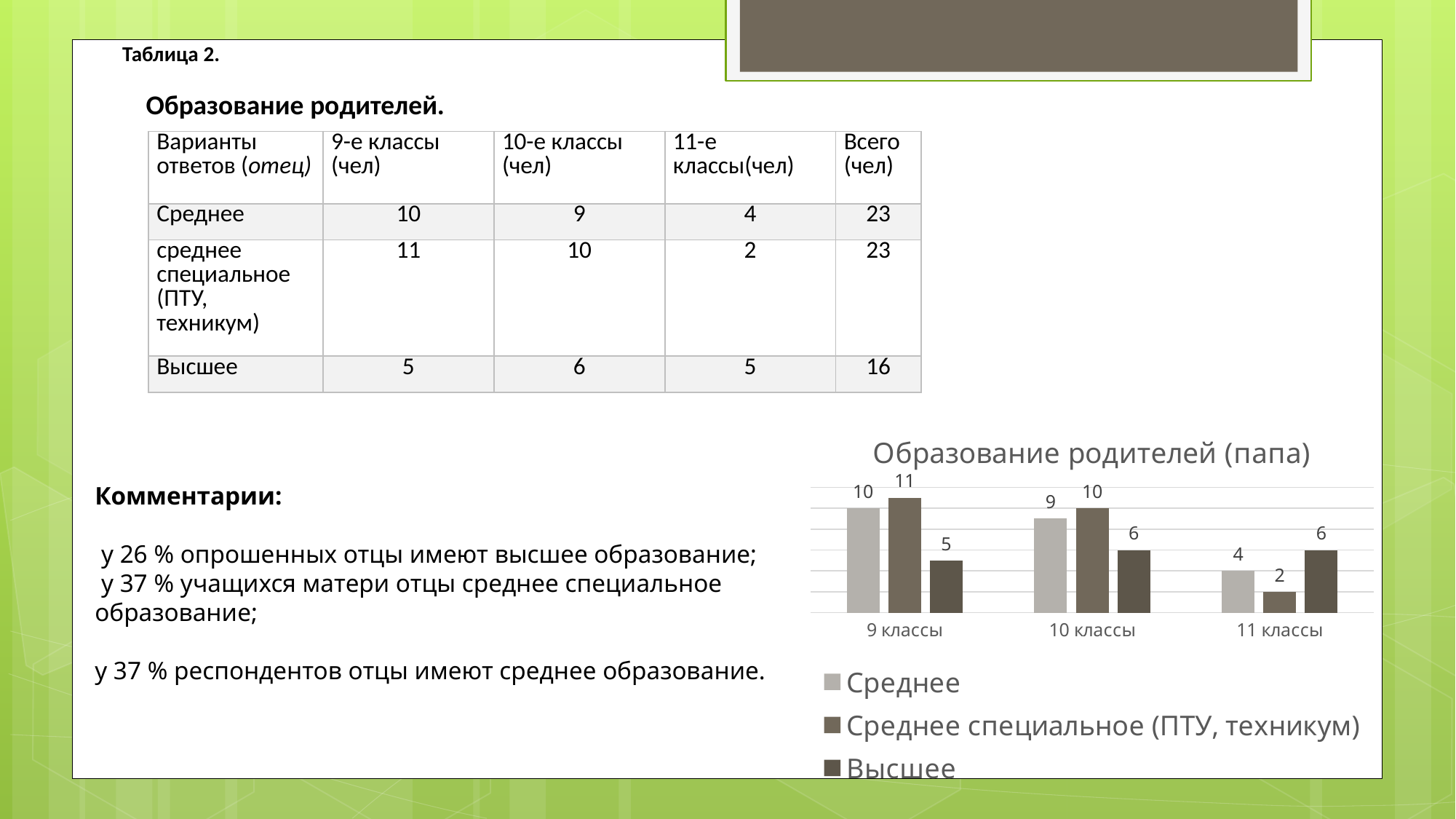
Does the Среднее специальное (ПТУ, техникум) series rise or fall from 9 классы to 11 классы? fall What is the value for Высшее in the 11 классы group? 6 Which category has the highest value for the Среднее специальное (ПТУ, техникум) series? 9 классы What is the value for Среднее in the 9 классы group? 10 Which is larger in the 11 классы group: Среднее or Высшее? Высшее Which category has the lowest value for the Среднее series? 11 классы What kind of chart is shown? bar chart What is the value for Среднее специальное (ПТУ, техникум) in the 10 классы group? 10 What is the difference between Среднее специальное (ПТУ, техникум) and Высшее in the 9 классы group? 6 How many series does the legend list? 3 What is the title of the chart? Образование родителей (папа) How many categories are shown on the x axis? 3